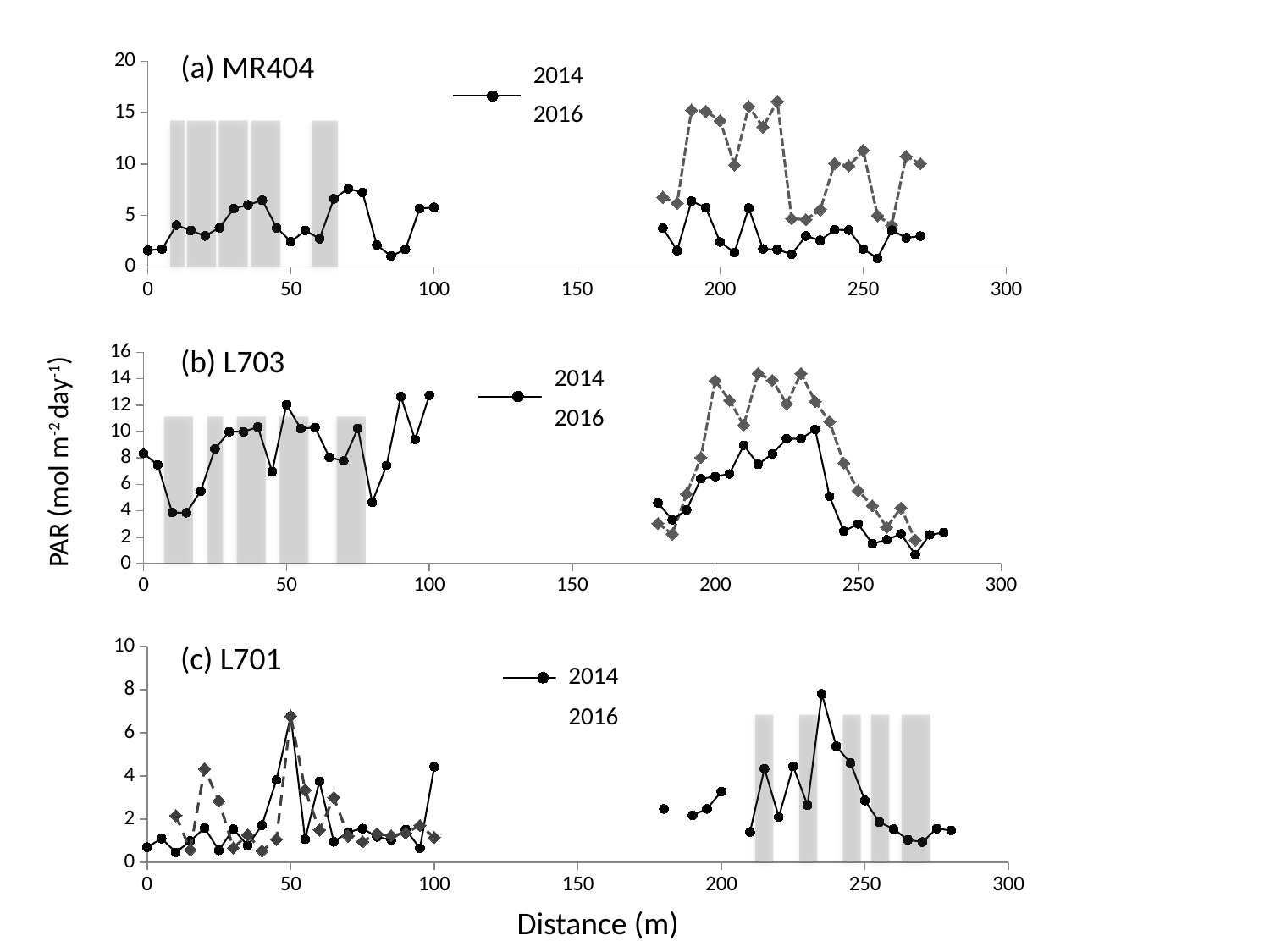
In panel (c) L701, at which distance does the 2014 series reach its highest value? 235 m What is the label of the y axis on the slide? PAR (mol m-2 day-1) In panel (b) L703, is the 2014 value at 100 m greater or less than 10? greater In panel (c) L701, is the 2014 value at 235 m greater or less than 6? greater What is the label of the shared x axis at the bottom of the slide? Distance (m) How many series does the legend list in panel (b) L703? 2 In panel (a) MR404, is the 2016 value at 230 m greater or less than 10? less In panel (a) MR404, at 220 m, which series has the larger value, 2014 or 2016? 2016 What kind of chart is used in panel (a) MR404? line chart In panel (b) L703, does the 2014 series rise or fall between 235 m and 270 m? fall